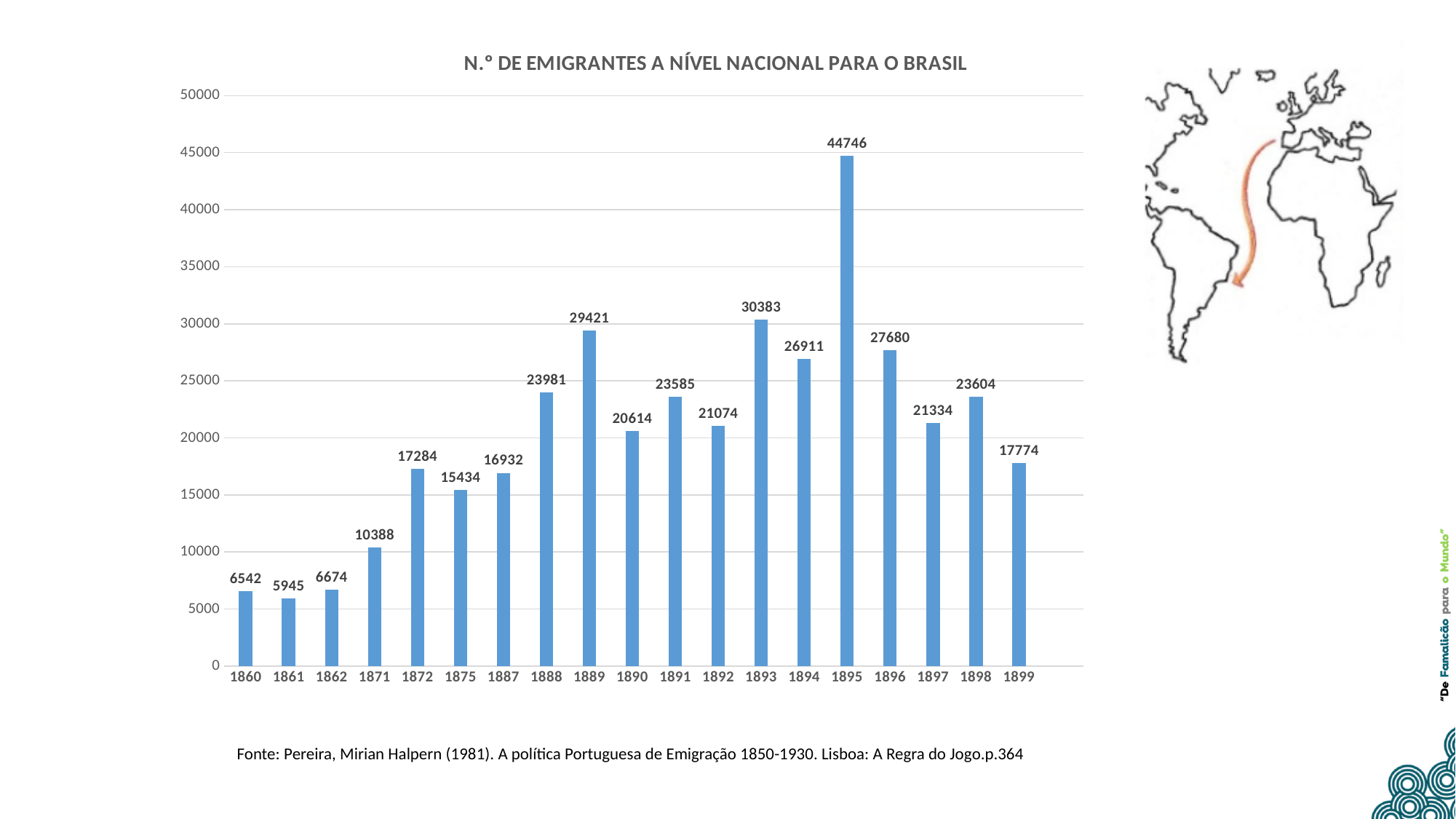
What is the number of emigrants to Brazil in 1899? 17774 Is the value for 1861 greater or less than 10000? less Which year has the highest number of emigrants to Brazil? 1895 Which year has the lowest number of emigrants to Brazil? 1861 What is the difference between the number of emigrants in 1889 and in 1888? 5440 What is the number of emigrants to Brazil in 1871? 10388 Which year has more emigrants, 1893 or 1896? 1893 How many years are shown on the x axis of the chart? 19 What kind of chart is shown on the slide? bar chart Do the values rise or fall from 1887 to 1889? rise What is the difference between the number of emigrants in 1895 and in 1893? 14363 What is the number of emigrants to Brazil in 1895? 44746